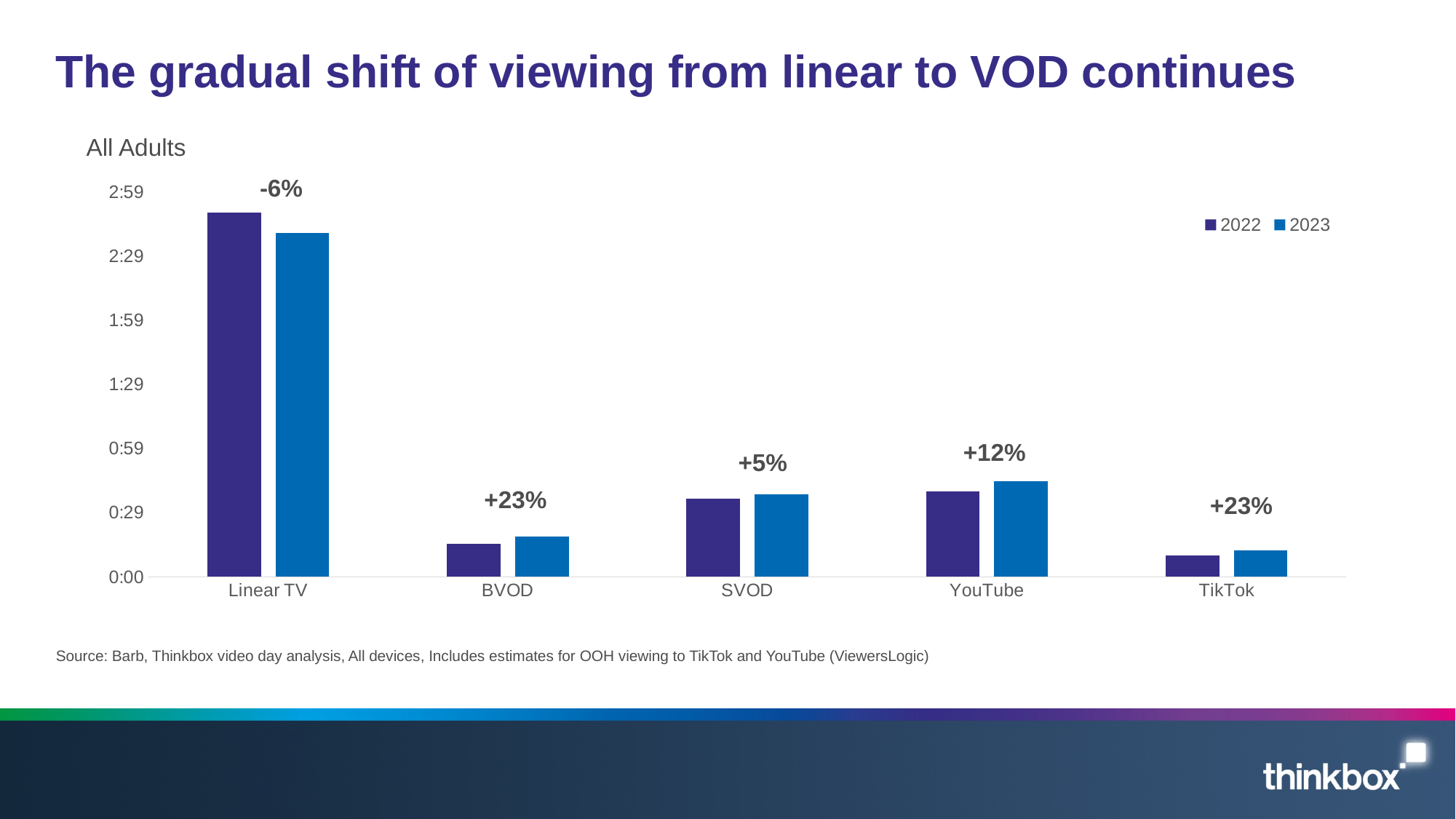
Which is larger in 2023: the value for SVOD or the value for YouTube? YouTube Is the 2022 value for Linear TV greater or less than 2:29? greater What percentage change is labelled above the Linear TV bars? -6% How many categories are shown on the x axis of the chart? 5 Is the 2023 value for YouTube greater or less than 0:59? less What percentage change is labelled above the YouTube bars? +12% How many series does the chart's legend list? 2 Which category has the lowest viewing time in 2022? TikTok What percentage change is labelled above the SVOD bars? +5% What percentage change is labelled above the BVOD bars? +23% What kind of chart is shown on the slide? bar chart Which category has the highest viewing time in 2023? Linear TV